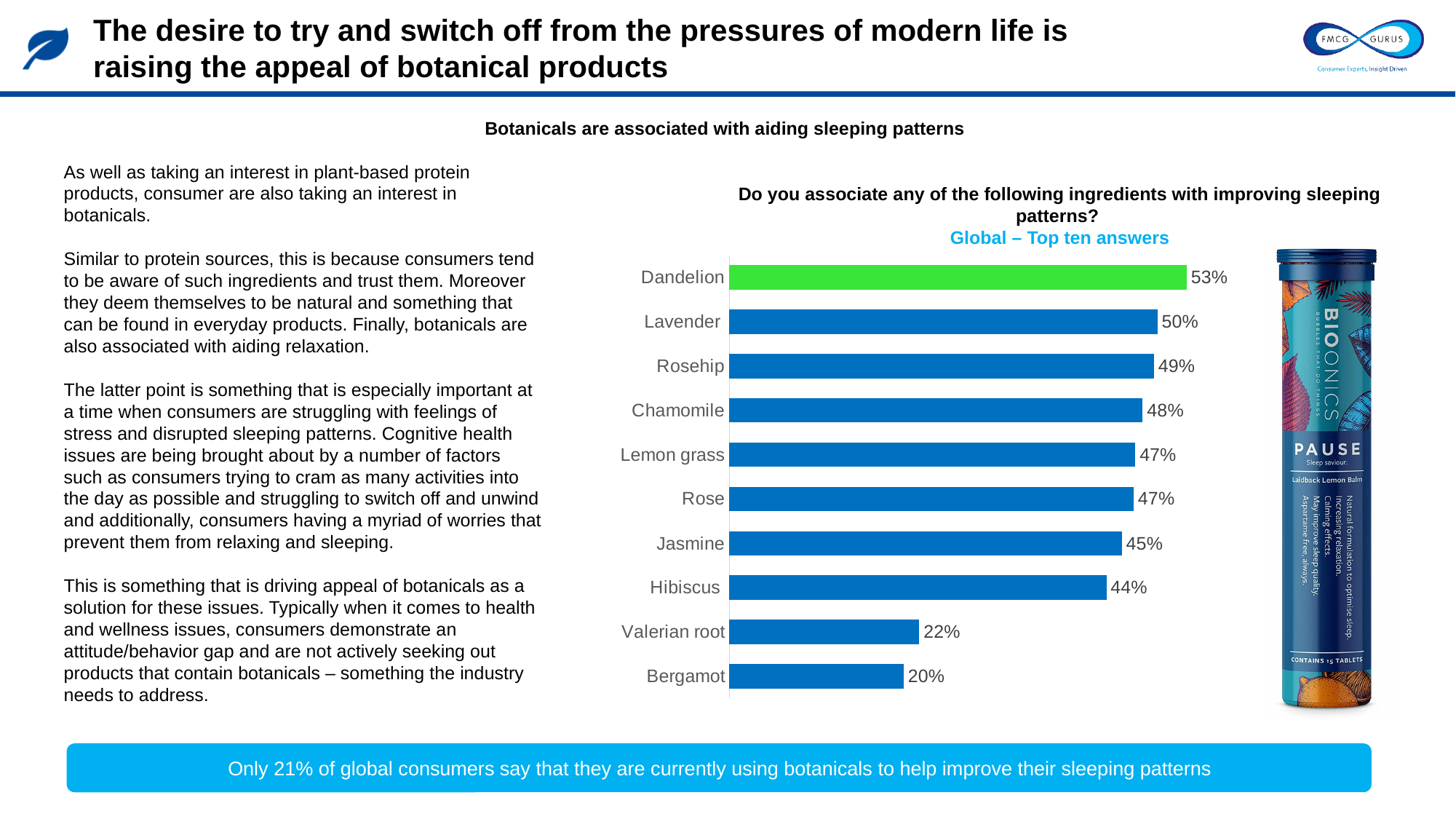
What is the difference between the values for Dandelion and Jasmine? 8% Which has a higher value, Chamomile or Hibiscus? Chamomile Which ingredient has the lowest percentage in the chart? Bergamot What is the value shown for Hibiscus? 44% Which bar in the chart is coloured green rather than blue? Dandelion How many ingredients are shown in the chart? 10 What percentage of consumers associate Dandelion with improving sleeping patterns? 53% What type of chart is used on the slide? Bar chart What is the difference between the values for Lavender and Bergamot? 30% Which two ingredients share the same value of 47%? Lemon grass and Rose Which ingredient has the highest percentage in the chart? Dandelion What is the value shown for Valerian root? 22%